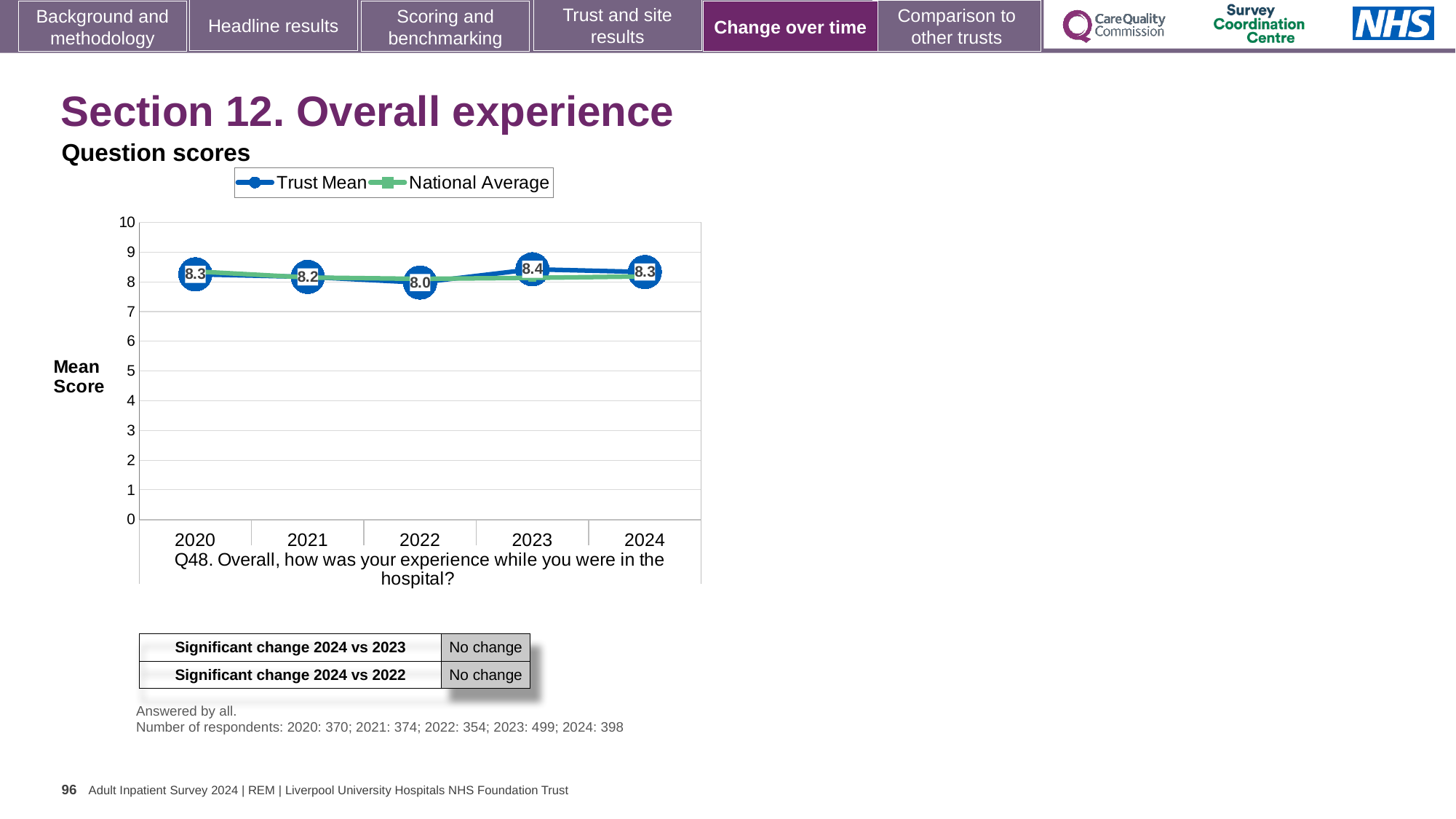
What is the Trust Mean score for 2020? 8.3 How many years are shown on the x axis of the chart? 5 Does the Trust Mean score rise or fall from 2021 to 2022? Fall What is the Trust Mean score for 2024? 8.3 Which year has the larger Trust Mean score, 2021 or 2023? 2023 What is the difference between the Trust Mean scores for 2023 and 2022? 0.4 In which year is the Trust Mean score lowest? 2022 What kind of chart is shown on the slide? Line chart Is the National Average value for 2024 greater or less than 5? greater How many series does the chart legend list? 2 In which year is the Trust Mean score highest? 2023 What is the Trust Mean score for 2022? 8.0